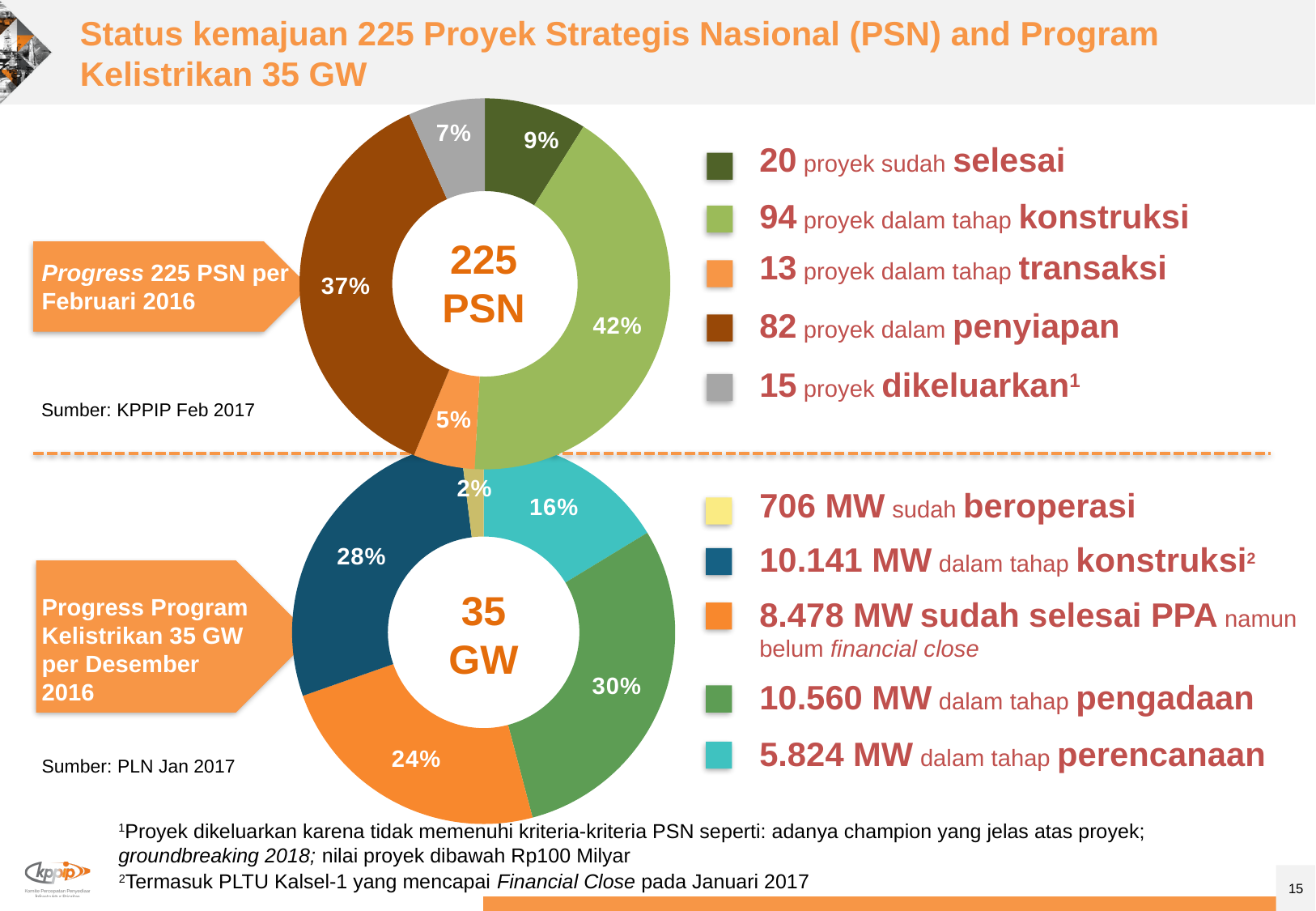
In the top chart (225 PSN), which category has the smallest share? transaksi In the top chart (225 PSN), what is the difference in percentage points between konstruksi and penyiapan? 5 In the top chart (225 PSN), what percentage of projects are in penyiapan? 37% How many categories does the bottom chart (35 GW) show? 5 In the top chart (225 PSN), how many projects are in the transaksi stage according to the legend? 13 In the bottom chart (35 GW), what percentage is in the pengadaan stage? 30% What type of chart is used for the 225 PSN progress? Pie (donut) chart In the bottom chart (35 GW), how many MW are in the perencanaan stage according to the legend? 5.824 MW In the top chart (225 PSN), what percentage of projects are in the konstruksi stage? 42% In the top chart (225 PSN), which category has the largest share? konstruksi In the bottom chart (35 GW), which is larger: the share for konstruksi or the share for perencanaan? konstruksi In the bottom chart (35 GW), which category has the smallest share? beroperasi